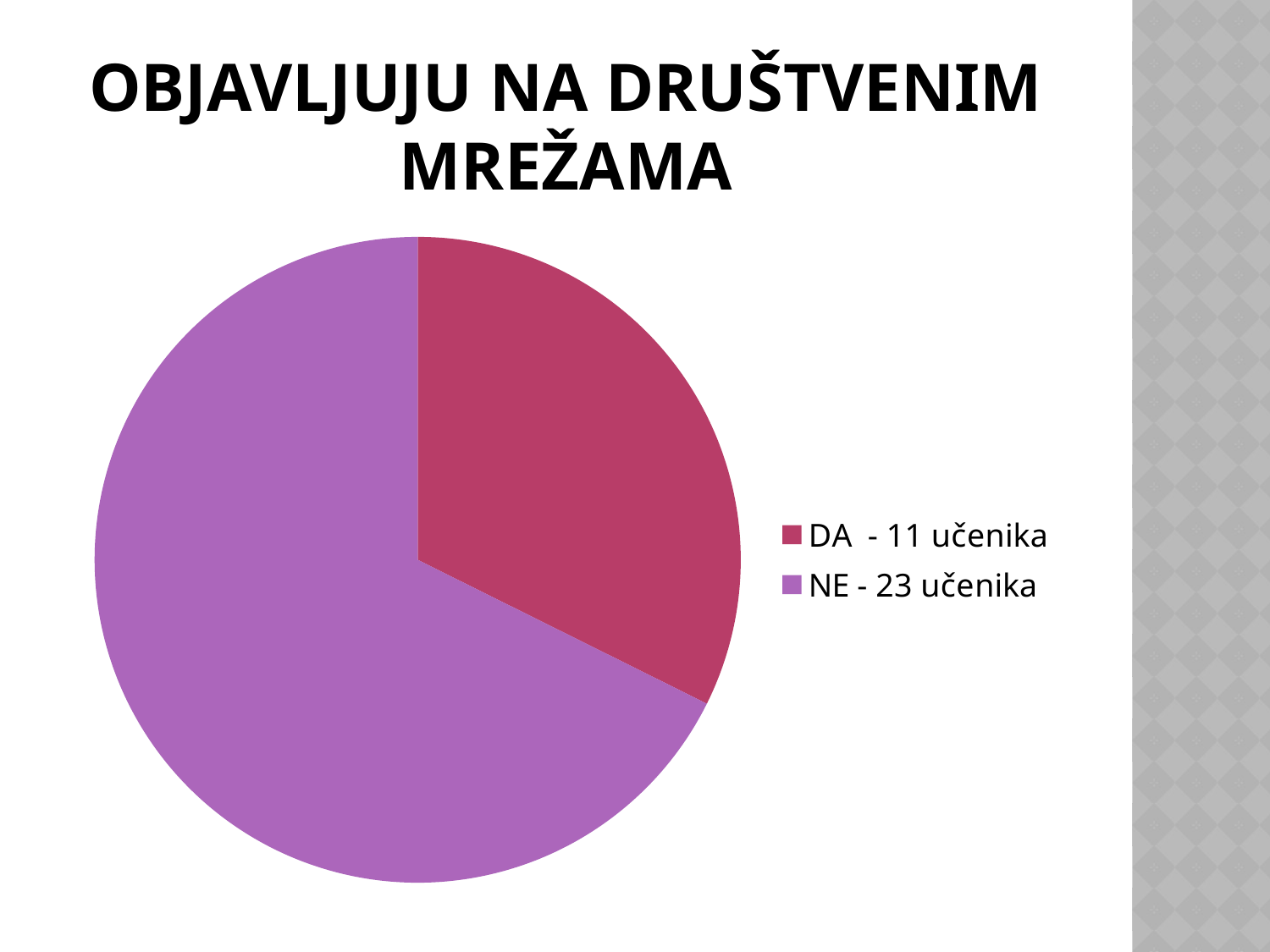
How many students answered NE according to the legend? 23 učenika Which category has the smallest slice of the pie? DA What is the total number of students represented in the pie chart? 34 How many slices does the pie chart have? 2 How many entries does the legend list? 2 What is the difference between the number of students who answered NE and those who answered DA? 12 What is the title of the slide containing the pie chart? OBJAVLJUJU NA DRUŠTVENIM MREŽAMA What kind of chart is shown on the slide? pie chart Which category has the larger slice of the pie, DA or NE? NE What colour is the slice for NE - 23 učenika? purple How many students answered DA according to the legend? 11 učenika Which category has the largest slice of the pie? NE